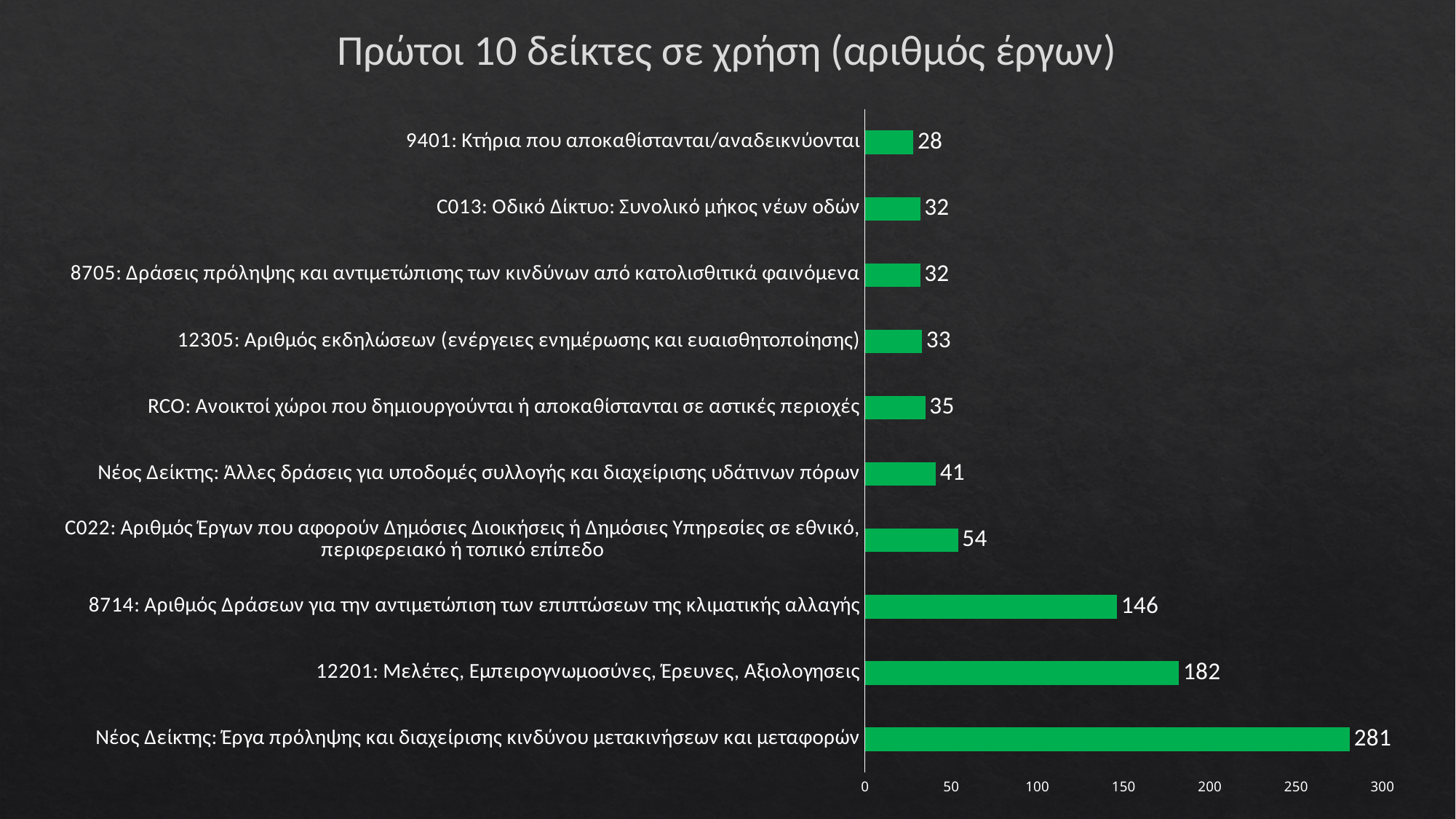
Is the value for '12201: Μελέτες, Εμπειρογνωμοσύνες, Έρευνες, Αξιολογησεις' greater or less than 150? greater What is the difference between the values for 'Νέος Δείκτης: Έργα πρόληψης και διαχείρισης κινδύνου μετακινήσεων και μεταφορών' and '12201: Μελέτες, Εμπειρογνωμοσύνες, Έρευνες, Αξιολογησεις'? 99 Which is larger: the value for '8714: Αριθμός Δράσεων για την αντιμετώπιση των επιπτώσεων της κλιματικής αλλαγής' or the value for 'Νέος Δείκτης: Άλλες δράσεις για υποδομές συλλογής και διαχείρισης υδάτινων πόρων'? 8714: Αριθμός Δράσεων για την αντιμετώπιση των επιπτώσεων της κλιματικής αλλαγής What is the title of the chart? Πρώτοι 10 δείκτες σε χρήση (αριθμός έργων) What is the difference between the values for '8714: Αριθμός Δράσεων για την αντιμετώπιση των επιπτώσεων της κλιματικής αλλαγής' and 'C022: Αριθμός Έργων που αφορούν Δημόσιες Διοικήσεις ή Δημόσιες Υπηρεσίες σε εθνικό, περιφερειακό ή τοπικό επίπεδο'? 92 How many categories are shown in the chart? 10 What is the value for '9401: Κτήρια που αποκαθίστανται/αναδεικνύονται'? 28 What kind of chart is shown on the slide? bar chart What is the value for '12201: Μελέτες, Εμπειρογνωμοσύνες, Έρευνες, Αξιολογησεις'? 182 Which category has the lowest value? 9401: Κτήρια που αποκαθίστανται/αναδεικνύονται Which category has the highest value? Νέος Δείκτης: Έργα πρόληψης και διαχείρισης κινδύνου μετακινήσεων και μεταφορών What is the value for 'RCO: Ανοικτοί χώροι που δημιουργούνται ή αποκαθίστανται σε αστικές περιοχές'? 35